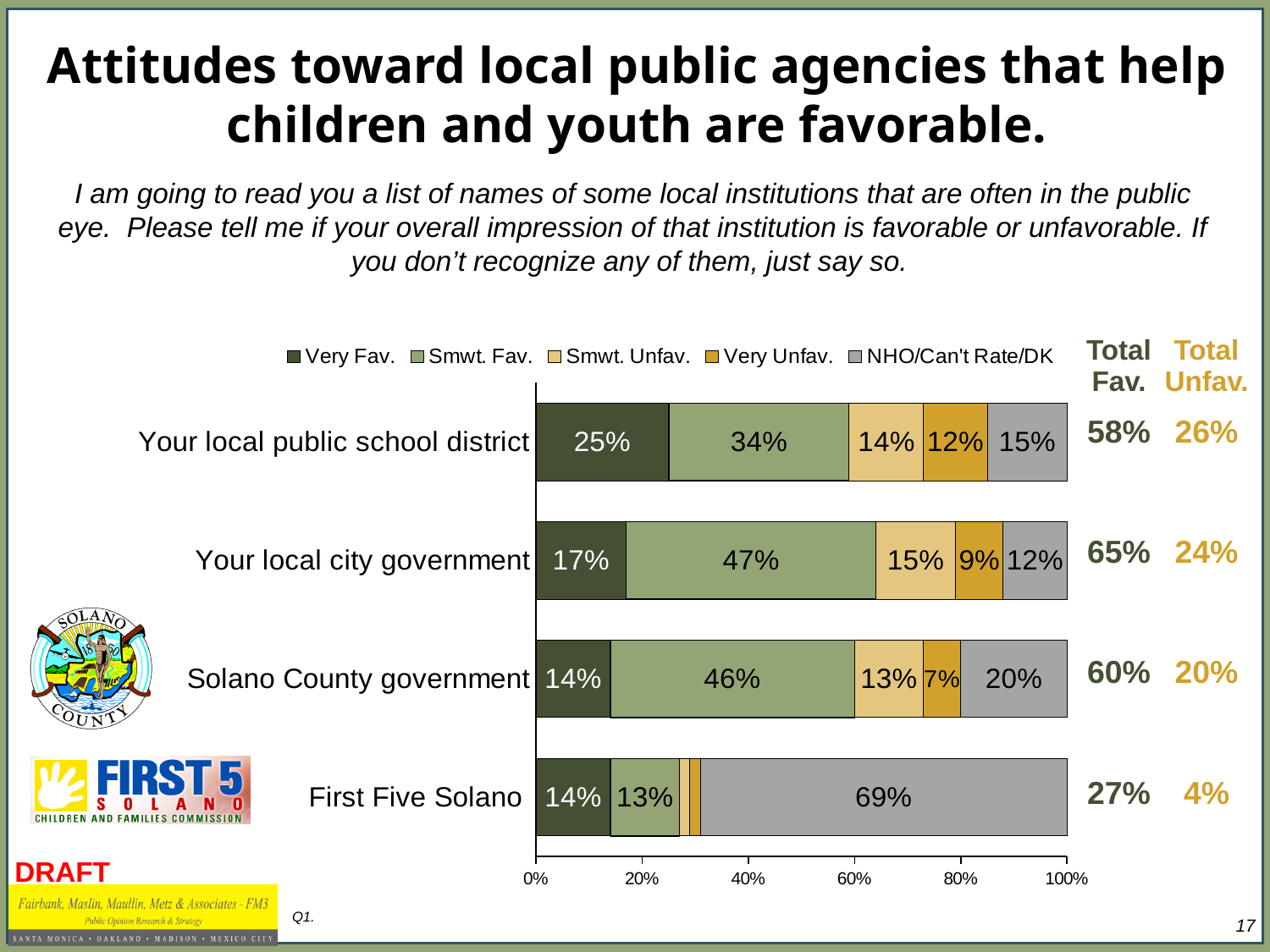
How many series does the legend list? 5 How many institutions are shown in the chart? 4 What is the Smwt. Fav. value for your local city government? 47% What is the NHO/Can't Rate/DK value for First Five Solano? 69% What percentage of respondents have a Very Fav. impression of their local public school district? 25% What is the Total Unfav. value for Solano County government? 20% Which institution has the lowest Total Unfav. percentage? First Five Solano What is the Very Unfav. value for Solano County government? 7% Which has a larger Very Fav. share: your local public school district or your local city government? Your local public school district What is the difference in Total Fav. between your local city government and your local public school district? 7 percentage points Which institution has the highest Total Fav. percentage? Your local city government What type of chart is shown on the slide? Stacked bar chart